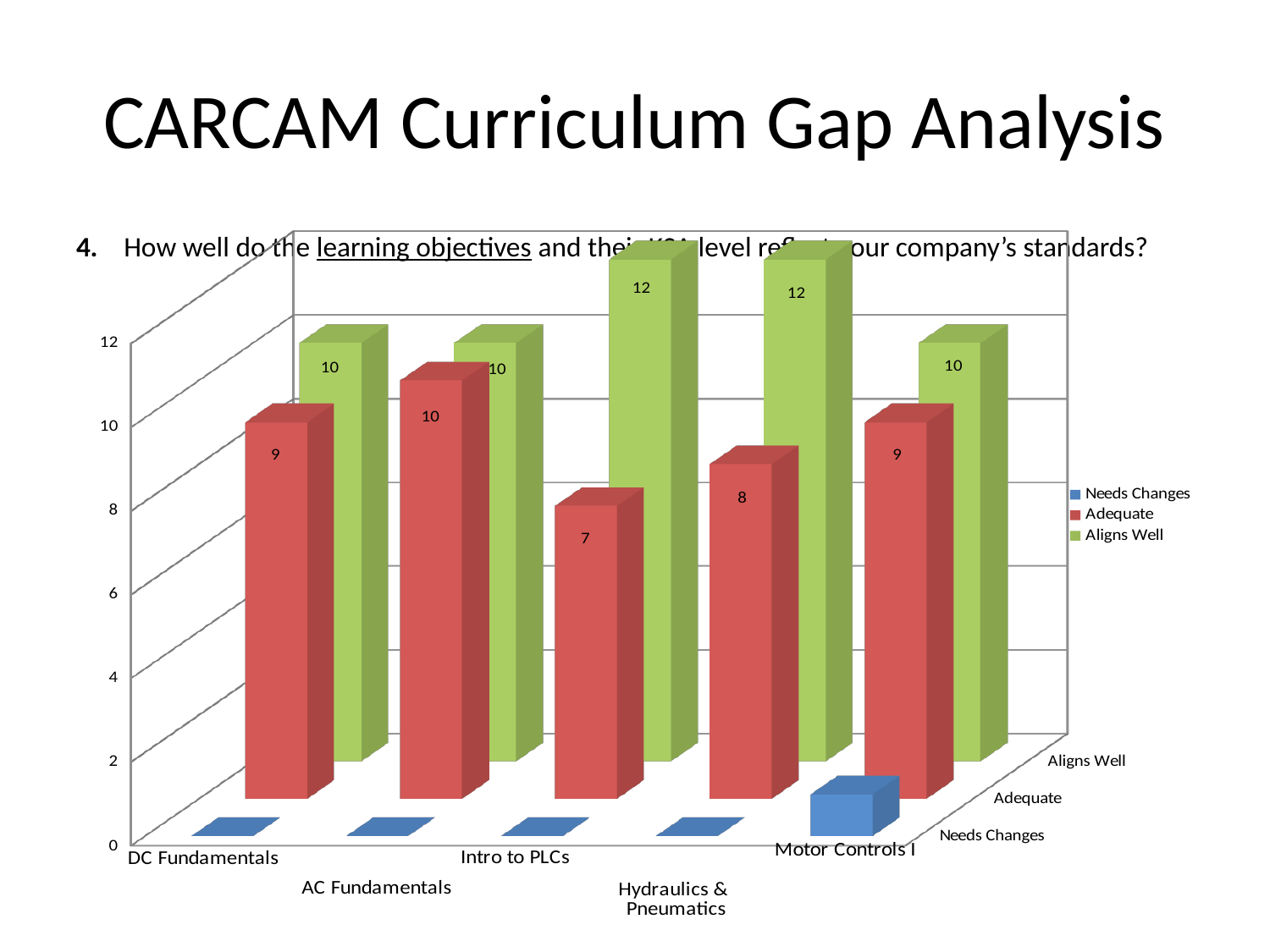
What is the Aligns Well value for Hydraulics & Pneumatics? 12 Which is larger for DC Fundamentals, the Adequate value or the Aligns Well value? Aligns Well Which series is shown in green in the legend? Aligns Well What is the Adequate value for AC Fundamentals? 10 Which category has the lowest Adequate value? Intro to PLCs What is the Aligns Well value for Motor Controls I? 10 What kind of chart is shown on the slide? Bar chart Which category has the highest Adequate value? AC Fundamentals How many series does the legend list? 3 What is the difference between the Aligns Well and Adequate values for Intro to PLCs? 5 How many categories are shown on the x axis? 5 What is the Adequate value for Intro to PLCs? 7